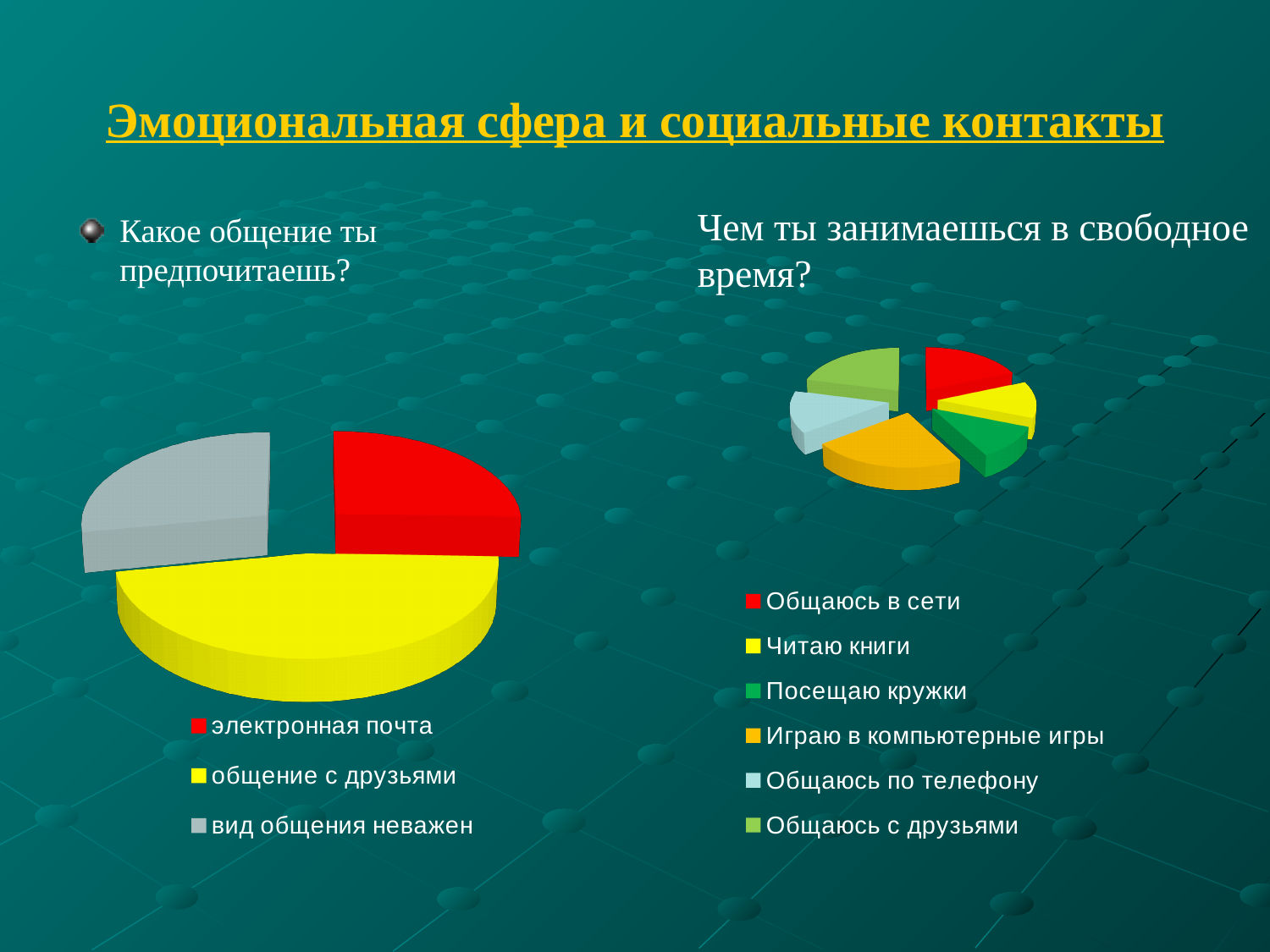
In the left chart ("Какое общение ты предпочитаешь?"), which slice is larger: "электронная почта" or "общение с друзьями"? общение с друзьями In the left chart ("Какое общение ты предпочитаешь?"), which category has the largest slice? общение с друзьями In the right chart ("Чем ты занимаешься в свободное время?"), how many entries does the legend list? 6 In the left chart ("Какое общение ты предпочитаешь?"), how many slices does the pie have? 3 What kind of chart is the left chart, titled "Какое общение ты предпочитаешь?"? pie chart In the right chart ("Чем ты занимаешься в свободное время?"), which slice is larger: "Общаюсь в сети" or "Играю в компьютерные игры"? Играю в компьютерные игры In the right chart ("Чем ты занимаешься в свободное время?"), what colour is the slice for "Читаю книги"? yellow In the right chart ("Чем ты занимаешься в свободное время?"), how many slices does the pie have? 6 In the left chart ("Какое общение ты предпочитаешь?"), what colour is the slice for "вид общения неважен"? grey What kind of chart is the right chart, titled "Чем ты занимаешься в свободное время?"? pie chart In the left chart ("Какое общение ты предпочитаешь?"), how many entries does the legend list? 3 In the right chart ("Чем ты занимаешься в свободное время?"), which category has the largest slice? Играю в компьютерные игры